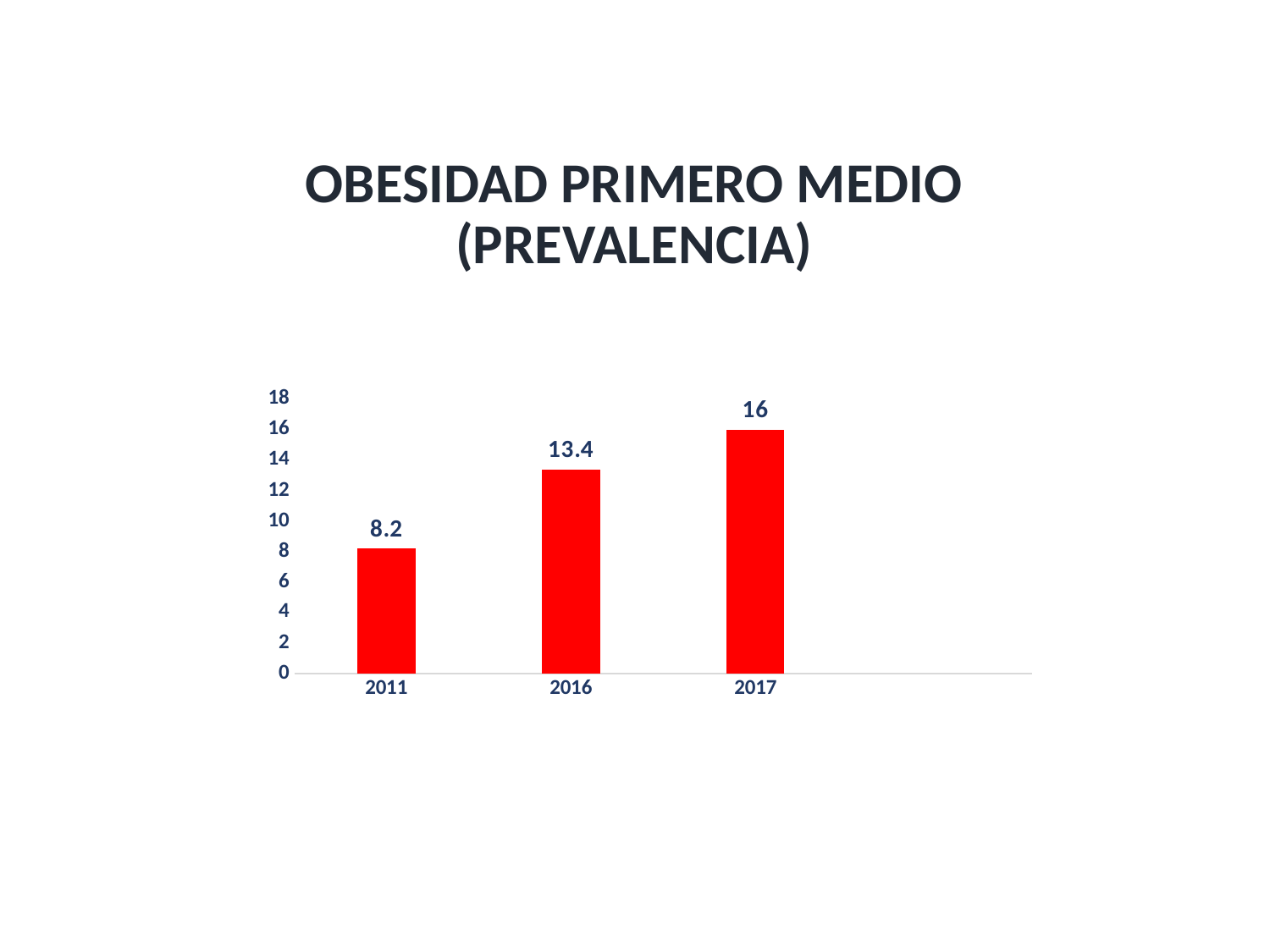
Which is larger, the value for 2016 or the value for 2017? 2017 Do the values rise or fall from 2011 to 2017? rise What is the difference between the values for 2017 and 2011? 7.8 Which year has the highest value? 2017 What is the value for 2017? 16 Is the value for 2016 greater or less than 12? greater What kind of chart is shown on the slide? bar chart What is the value for 2011? 8.2 What is the value for 2016? 13.4 What is the difference between the values for 2016 and 2011? 5.2 Which year has the lowest value? 2011 How many years are shown on the chart? 3